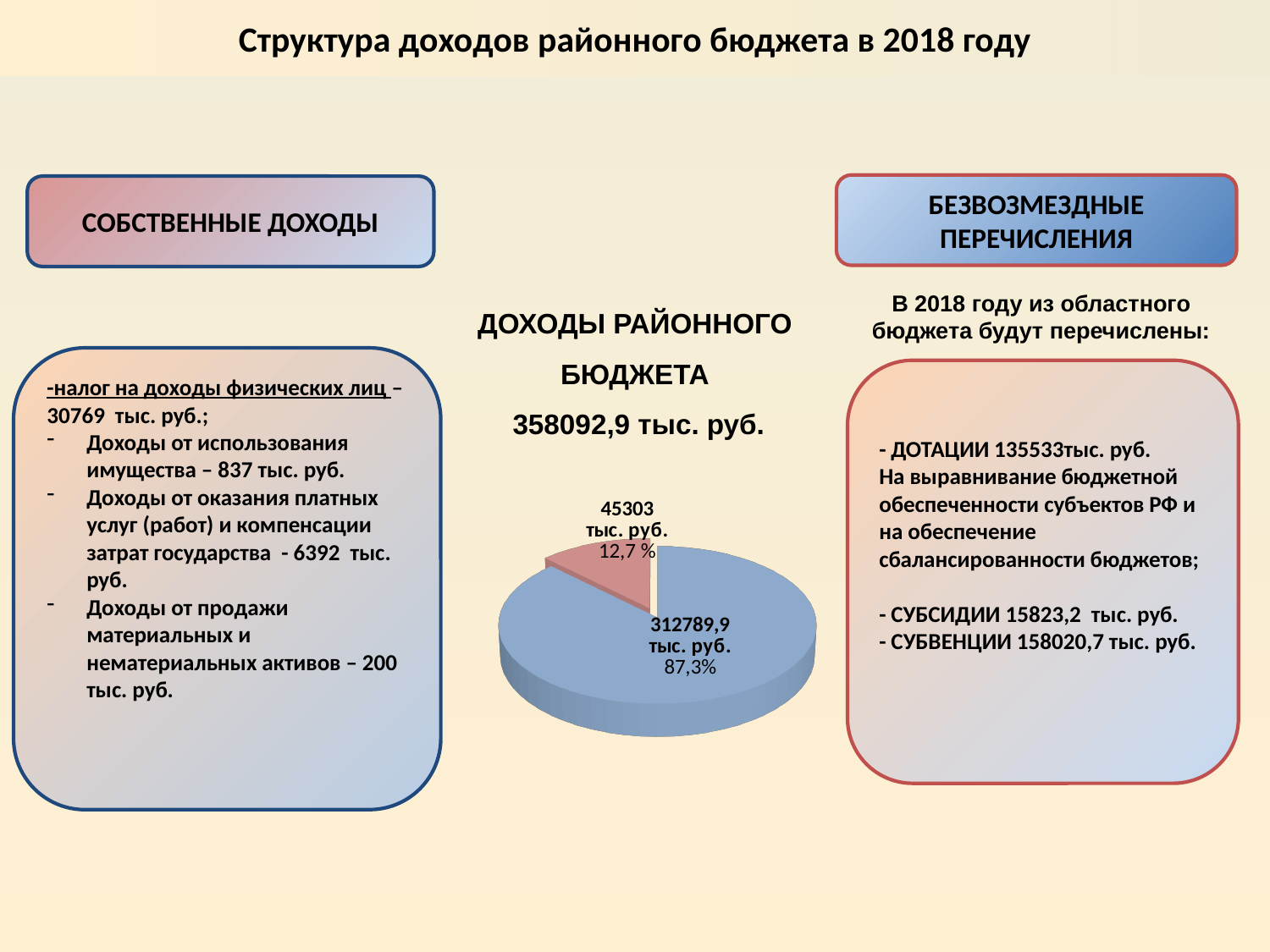
What kind of chart is shown in the centre of the slide? pie chart What colour is the slice labelled 12,7 % in the pie chart? pink What share of the pie does the pink slice represent? 12,7 % Which slice of the pie chart is larger, the blue one or the pink one? the blue one What is the total of the two slice values in the pie chart? 358092,9 тыс. руб. What is the value of the smallest slice in the pie chart? 45303 тыс. руб. What is the value of the largest slice in the pie chart? 312789,9 тыс. руб. What value is labelled on the blue slice of the pie chart? 312789,9 тыс. руб. How many slices does the pie chart have? 2 What value is labelled on the pink slice of the pie chart? 45303 тыс. руб. What share of the pie does the blue slice represent? 87,3% What is the difference between the values of the blue slice and the pink slice in the pie chart? 267486,9 тыс. руб.